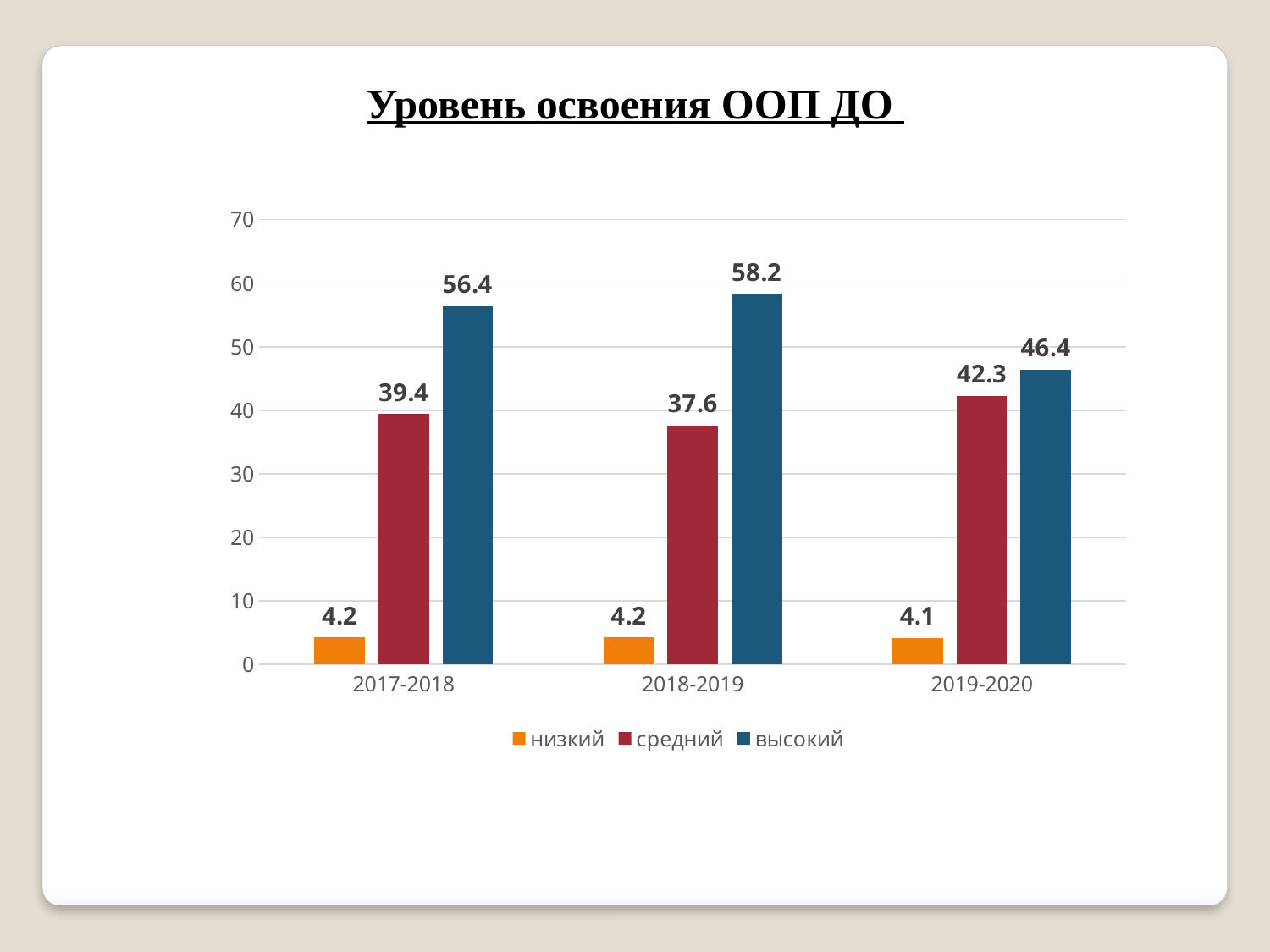
What is the difference between the высокий values for 2018-2019 and 2019-2020? 11.8 Which is larger in 2019-2020: средний or высокий? высокий How many year categories are shown on the x axis? 3 What kind of chart is shown on the slide? bar chart What is the value for низкий in 2017-2018? 4.2 What is the value for средний in 2019-2020? 42.3 In which year is the высокий value highest? 2018-2019 Is the value for высокий in 2017-2018 greater or less than 50? greater What is the value for высокий in 2018-2019? 58.2 How many series does the legend list? 3 What is the title of the chart? Уровень освоения ООП ДО In which year is the средний value lowest? 2018-2019